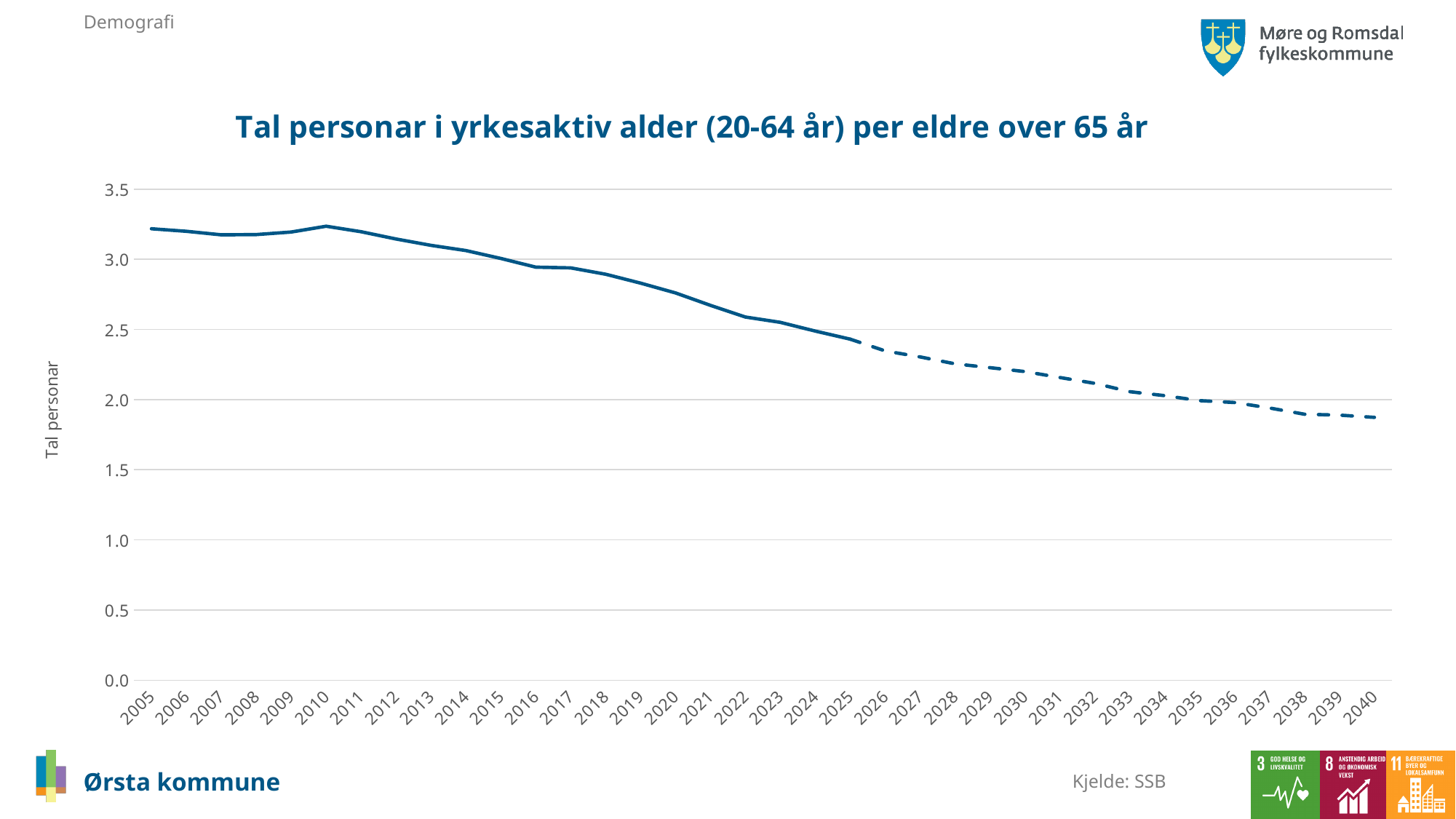
Is the value for 2030 greater or less than 2.5? less How many years are shown along the x axis of the chart? 36 Is the value for 2005 greater or less than 3.0? greater What is the title of the chart? Tal personar i yrkesaktiv alder (20-64 år) per eldre over 65 år What kind of chart is shown on the slide? line chart Do the values rise or fall overall from 2005 to 2040? fall Is the value for 2020 greater or less than 2.5? greater Which year has the larger value, 2005 or 2040? 2005 Which year has the lowest value on the chart? 2040 What is the label on the vertical axis of the chart? Tal personar Which year has the larger value, 2015 or 2025? 2015